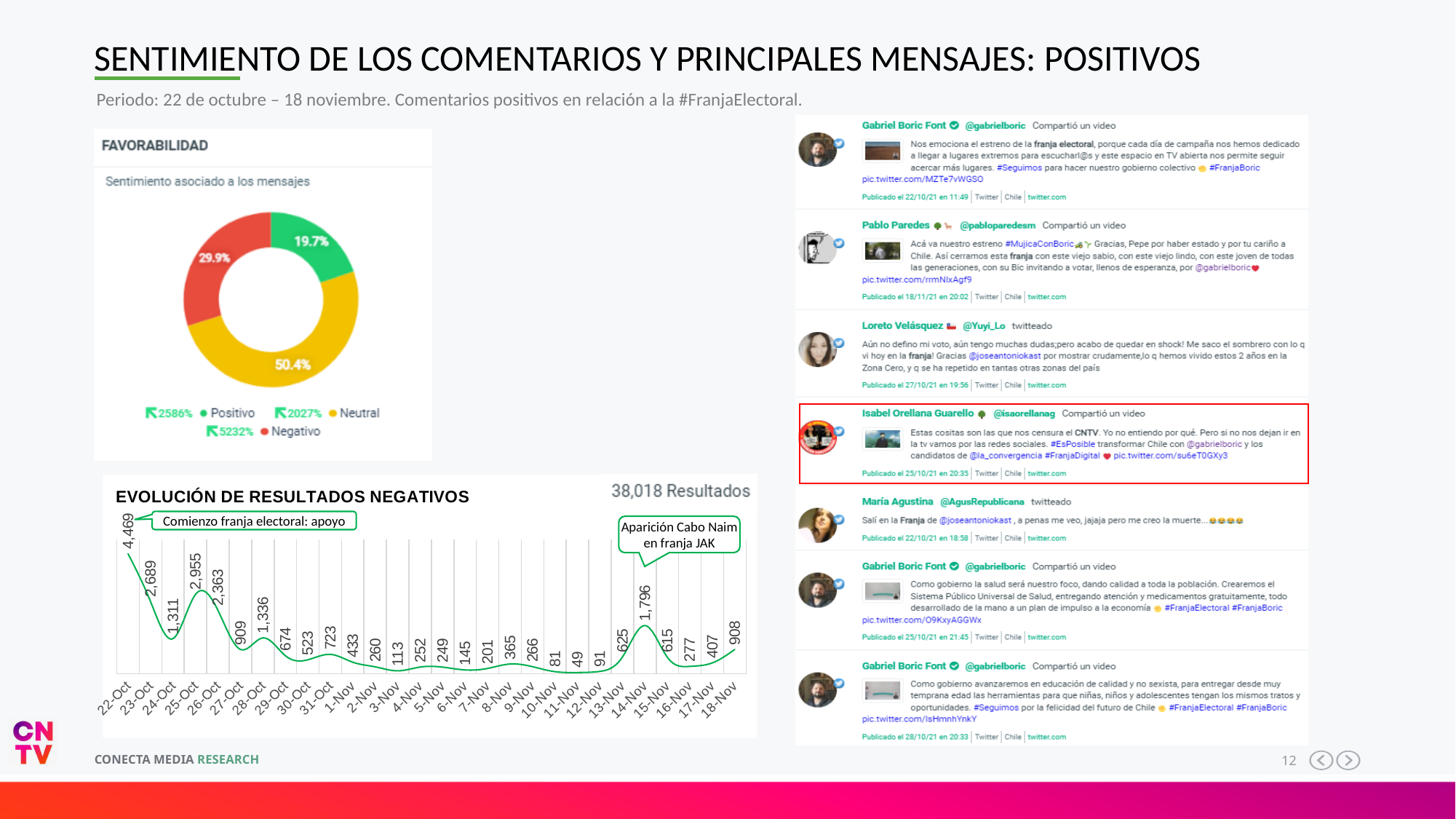
In the FAVORABILIDAD donut chart, what percentage of messages are Neutral? 50.4% In the EVOLUCIÓN DE RESULTADOS NEGATIVOS chart, how many dates are plotted on the x axis? 28 In the FAVORABILIDAD donut chart, which colour represents Positivo? Green In the EVOLUCIÓN DE RESULTADOS NEGATIVOS chart, what is the value for 14-Nov? 1,796 In the EVOLUCIÓN DE RESULTADOS NEGATIVOS chart, which is larger, the value for 25-Oct or the value for 26-Oct? 25-Oct In the FAVORABILIDAD donut chart, which sentiment category has the smallest share? Positivo In the EVOLUCIÓN DE RESULTADOS NEGATIVOS chart, which date has the lowest value? 11-Nov In the FAVORABILIDAD donut chart, what is the difference in percentage points between Neutral and Negativo? 20.5 In the FAVORABILIDAD donut chart, what percentage of messages are Negativo? 29.9% What kind of chart is EVOLUCIÓN DE RESULTADOS NEGATIVOS? Line chart In the FAVORABILIDAD donut chart, how many sentiment categories does the legend list? 3 In the EVOLUCIÓN DE RESULTADOS NEGATIVOS chart, what is the value for 22-Oct? 4,469